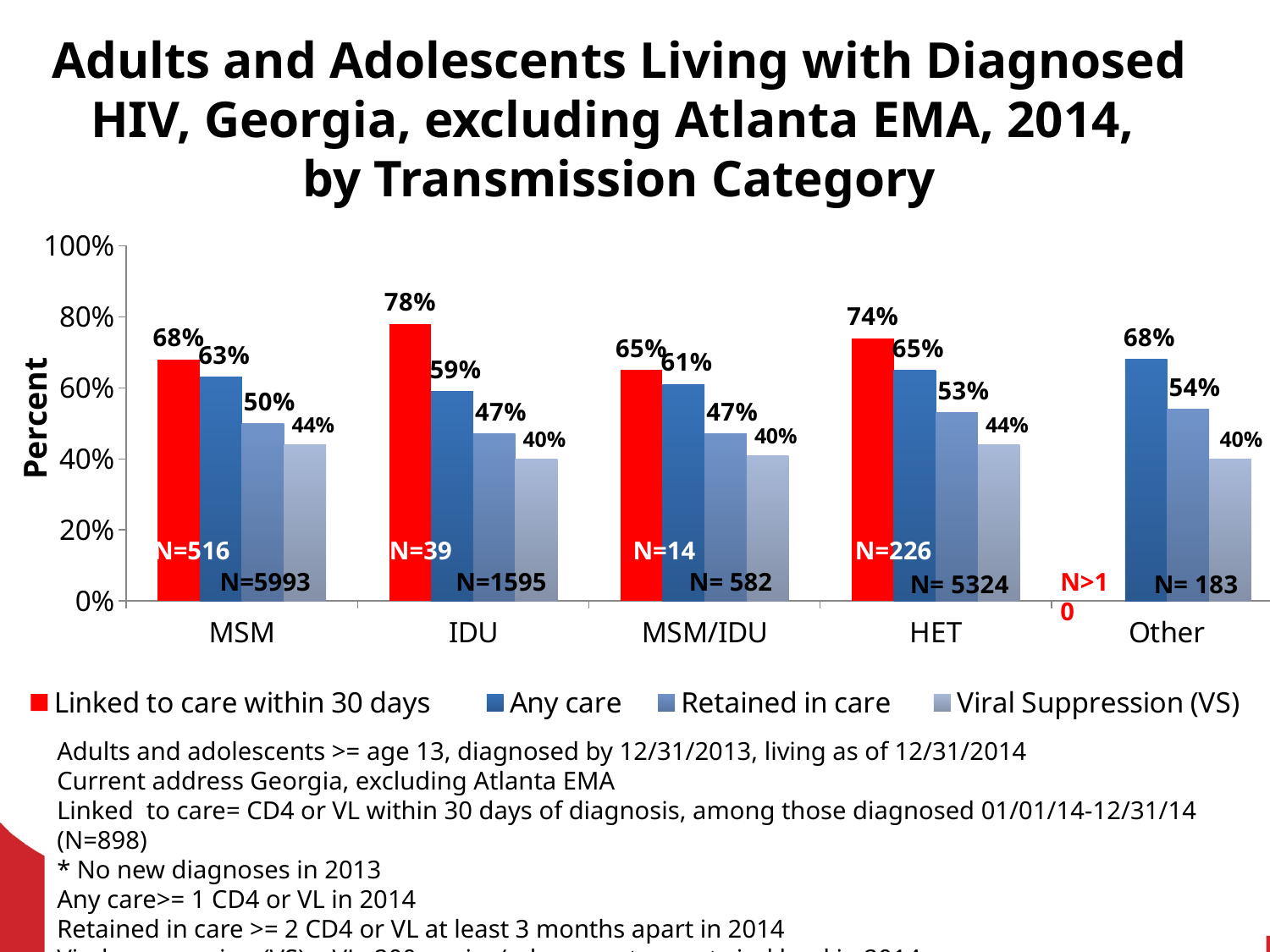
What kind of chart is shown on the slide? Bar chart What is the Viral Suppression (VS) value for the HET category? 44% What is the difference between the Linked to care within 30 days value and the Viral Suppression (VS) value for the IDU category? 38% What is the Retained in care value for the Other category? 54% What is the value for Linked to care within 30 days in the IDU category? 78% What is the value for Any care in the MSM category? 63% How many series does the legend list? 4 Is the Any care value for the Other category greater or less than 60%? greater How many transmission categories are shown on the x axis? 5 Which transmission category has the highest value for Linked to care within 30 days? IDU Which transmission category has the lowest value for Any care? IDU Which is larger: the Retained in care value for HET or the Retained in care value for MSM? HET